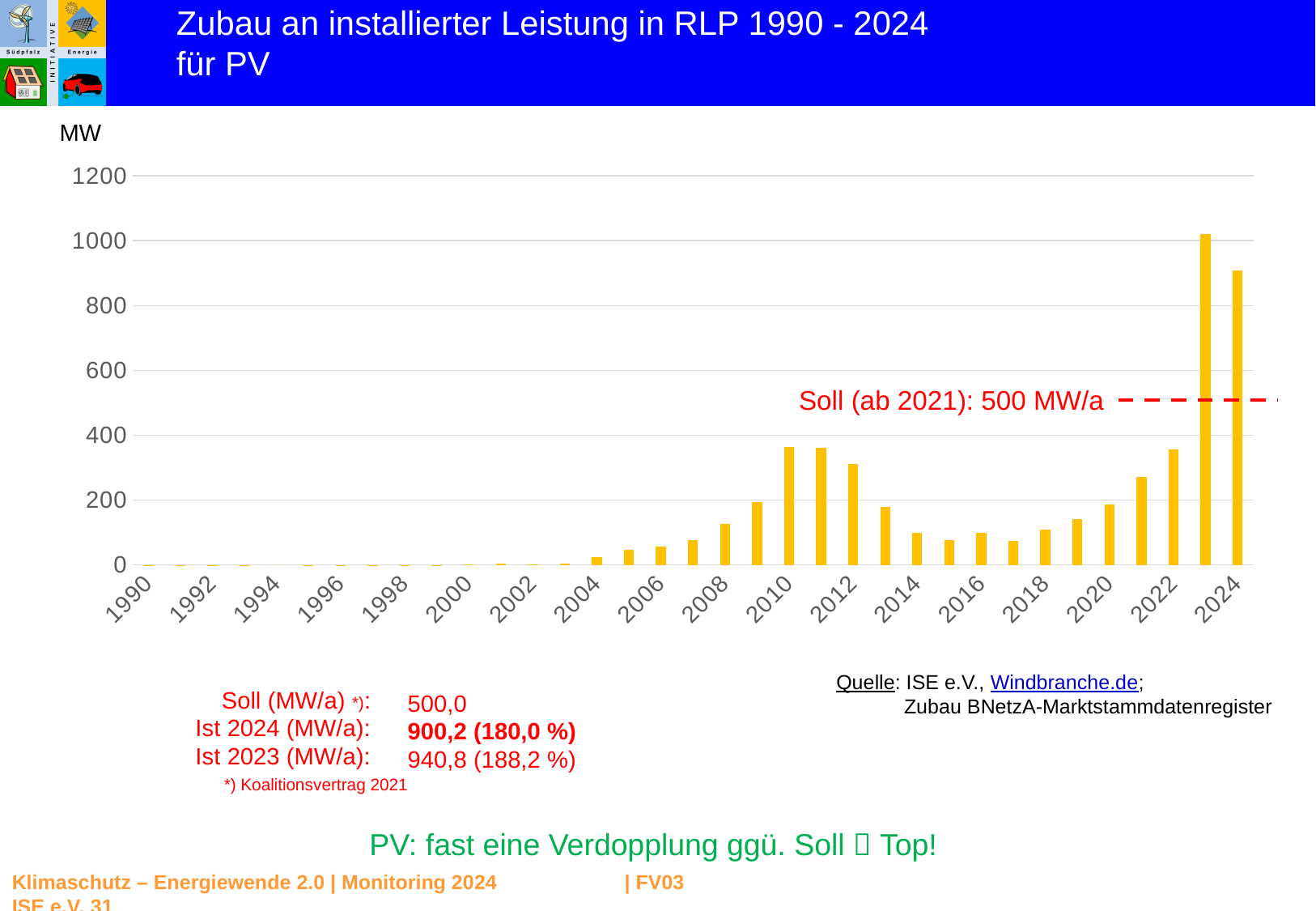
Do the values rise or fall from 2011 to 2014? fall Which year has the larger value, 2023 or 2024? 2023 What is the title of the chart? Zubau an installierter Leistung in RLP 1990 - 2024 für PV Is the value for 2014 greater or less than 200? less Is the value for 2021 greater or less than 200? greater Which year has the highest PV capacity addition? 2023 What kind of chart is shown on the slide? bar chart Is the value for 2024 greater or less than 800? greater Which year has the larger value, 2021 or 2022? 2022 What target value (Soll) is marked by the dashed line from 2021 onwards? 500 MW/a According to the text below the chart, what is the Ist 2024 value in MW/a? 900,2